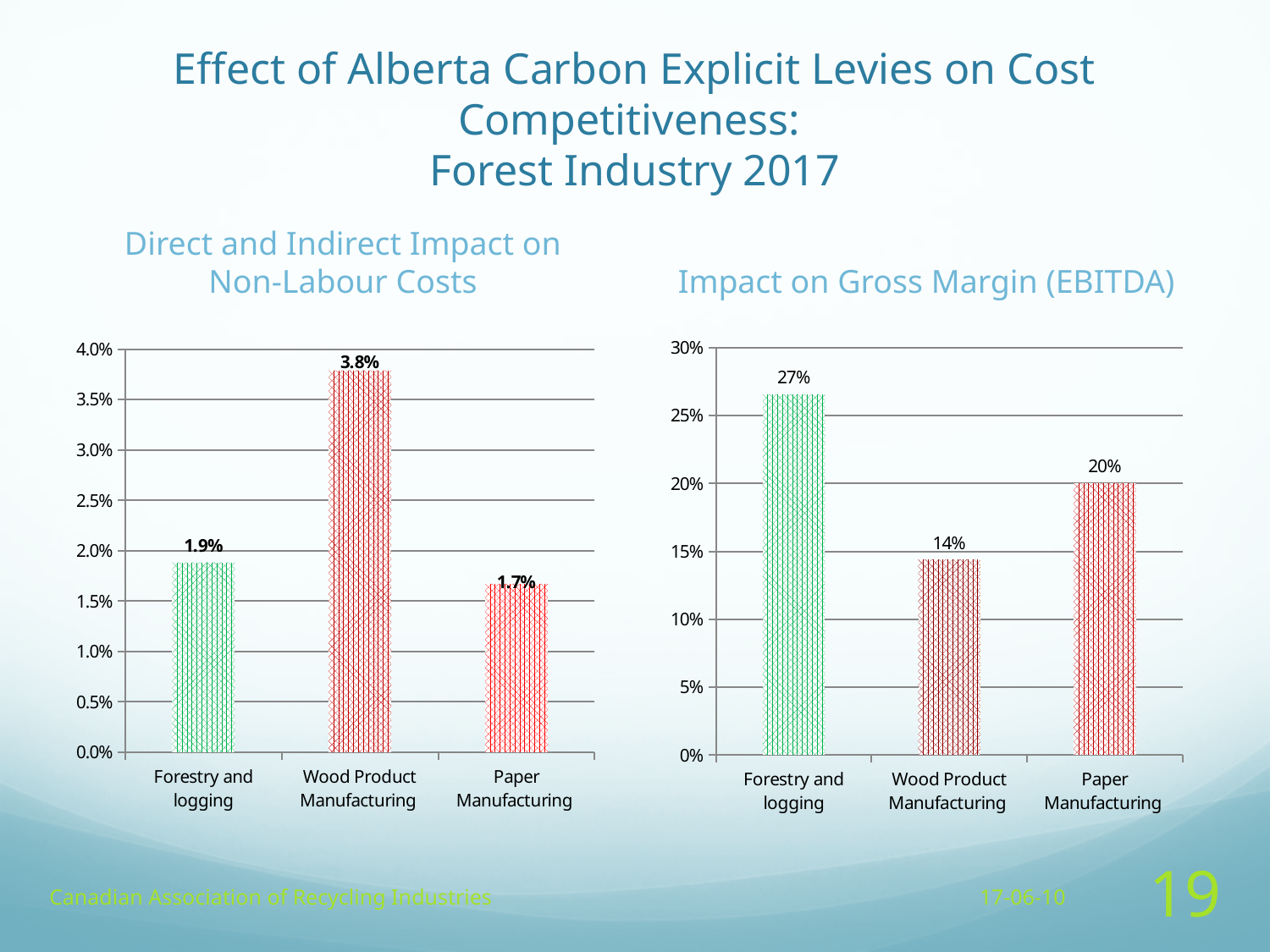
In the 'Impact on Gross Margin (EBITDA)' chart, which is larger: Paper Manufacturing or Wood Product Manufacturing? Paper Manufacturing What type of chart is the 'Impact on Gross Margin (EBITDA)' chart? Bar chart How many categories are shown in the 'Direct and Indirect Impact on Non-Labour Costs' chart? 3 In the 'Direct and Indirect Impact on Non-Labour Costs' chart, what is the difference between Wood Product Manufacturing and Paper Manufacturing? 2.1% In the 'Direct and Indirect Impact on Non-Labour Costs' chart, what is the value for Forestry and logging? 1.9% In the 'Impact on Gross Margin (EBITDA)' chart, what is the value for Paper Manufacturing? 20% In the 'Impact on Gross Margin (EBITDA)' chart, what is the difference between Forestry and logging and Wood Product Manufacturing? 13% In the 'Impact on Gross Margin (EBITDA)' chart, which category has the highest value? Forestry and logging In the 'Direct and Indirect Impact on Non-Labour Costs' chart, which category has the lowest value? Paper Manufacturing In the 'Impact on Gross Margin (EBITDA)' chart, which category has the lowest value? Wood Product Manufacturing What is the title of the chart on the right side of the slide? Impact on Gross Margin (EBITDA) In the 'Direct and Indirect Impact on Non-Labour Costs' chart, what is the value for Wood Product Manufacturing? 3.8%